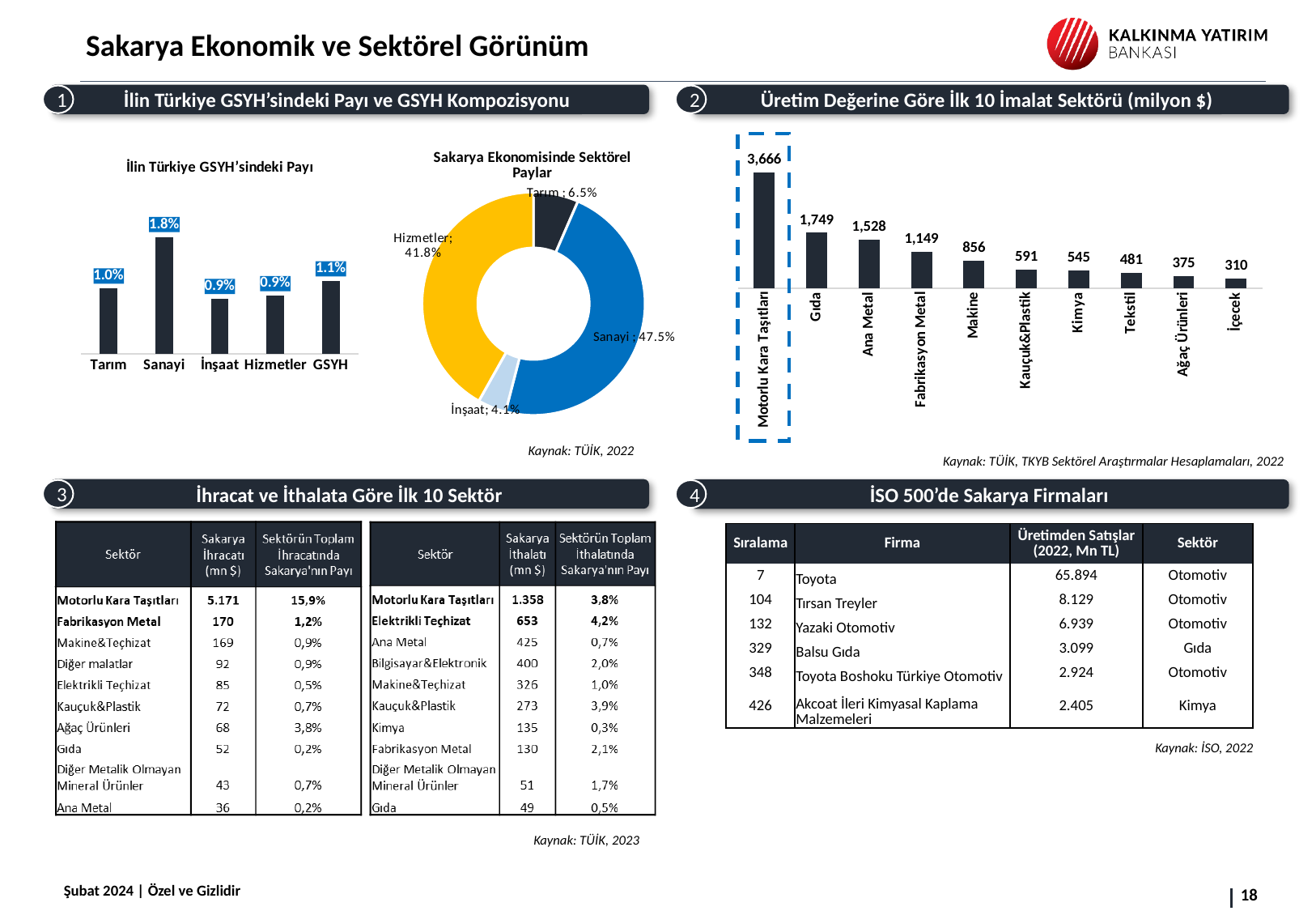
In the 'İlin Türkiye GSYH'sindeki Payı' chart, which category has the highest value? Sanayi In the 'İlin Türkiye GSYH'sindeki Payı' chart, what is the value for Sanayi? 1.8% In the 'Üretim Değerine Göre İlk 10 İmalat Sektörü (milyon $)' chart, what is the difference between Ana Metal and Fabrikasyon Metal? 379 In the 'Üretim Değerine Göre İlk 10 İmalat Sektörü (milyon $)' chart, what is the value for Gıda? 1,749 In the 'Üretim Değerine Göre İlk 10 İmalat Sektörü (milyon $)' chart, which sector has the highest value? Motorlu Kara Taşıtları In the 'Üretim Değerine Göre İlk 10 İmalat Sektörü (milyon $)' chart, which is larger, Kimya or Tekstil? Kimya In the 'İlin Türkiye GSYH'sindeki Payı' chart, how many categories are shown? 5 What kind of chart is 'Sakarya Ekonomisinde Sektörel Paylar'? Doughnut chart In the 'Sakarya Ekonomisinde Sektörel Paylar' chart, which sector has the smallest share? İnşaat In the 'İlin Türkiye GSYH'sindeki Payı' chart, what is the difference between the values for Sanayi and Tarım? 0.8% In the 'Sakarya Ekonomisinde Sektörel Paylar' chart, what share does Sanayi have? 47.5% In the 'Üretim Değerine Göre İlk 10 İmalat Sektörü (milyon $)' chart, do the values rise or fall from left to right? Fall